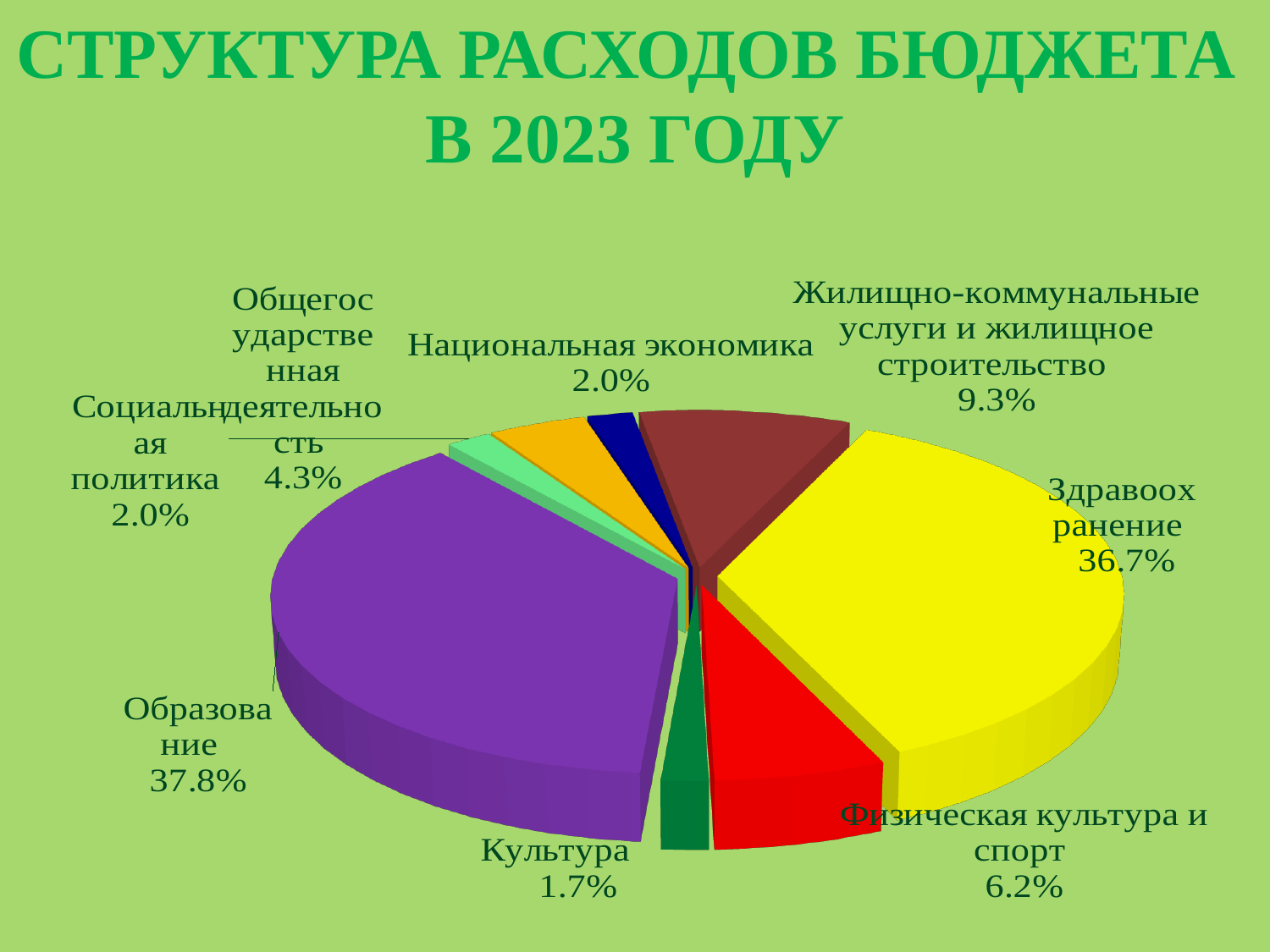
What is the title of the chart on the slide? СТРУКТУРА РАСХОДОВ БЮДЖЕТА В 2023 ГОДУ What kind of chart is shown on the slide? Pie chart How many categories are shown in the pie chart? 8 What share of the budget expenditure goes to Образование? 37.8% Which is larger: the share for Физическая культура и спорт or the share for Общегосударственная деятельность? Физическая культура и спорт What share of the budget expenditure goes to Здравоохранение? 36.7% Which category has the smallest share of the budget expenditure? Культура What is the difference in percentage points between Образование and Здравоохранение? 1.1 What percentage is shown for Физическая культура и спорт? 6.2% What percentage is shown for Общегосударственная деятельность? 4.3% What percentage is shown for Жилищно-коммунальные услуги и жилищное строительство? 9.3% Which category has the largest share of the budget expenditure? Образование